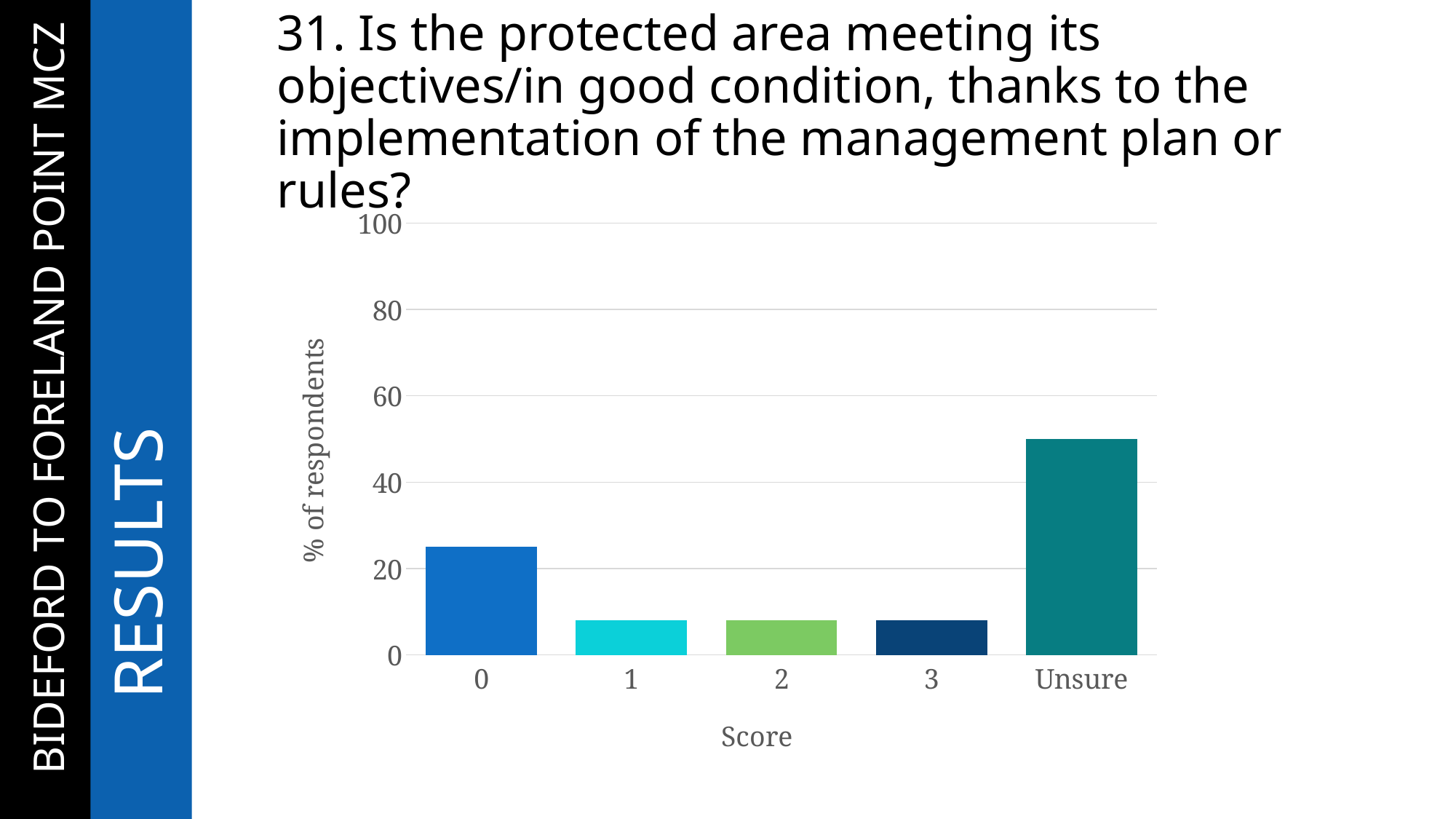
What is the label on the y axis of the chart? % of respondents What kind of chart is shown on the slide? bar chart Is the value for score 1 greater or less than 20? less Which category has the highest percentage of respondents? Unsure Is the value for Unsure greater or less than 40? greater Is the value for score 0 greater or less than 40? less Which is larger, the value for score 0 or the value for score 2? 0 Which is larger, the value for score 0 or the value for Unsure? Unsure How many score categories are shown on the x axis of the chart? 5